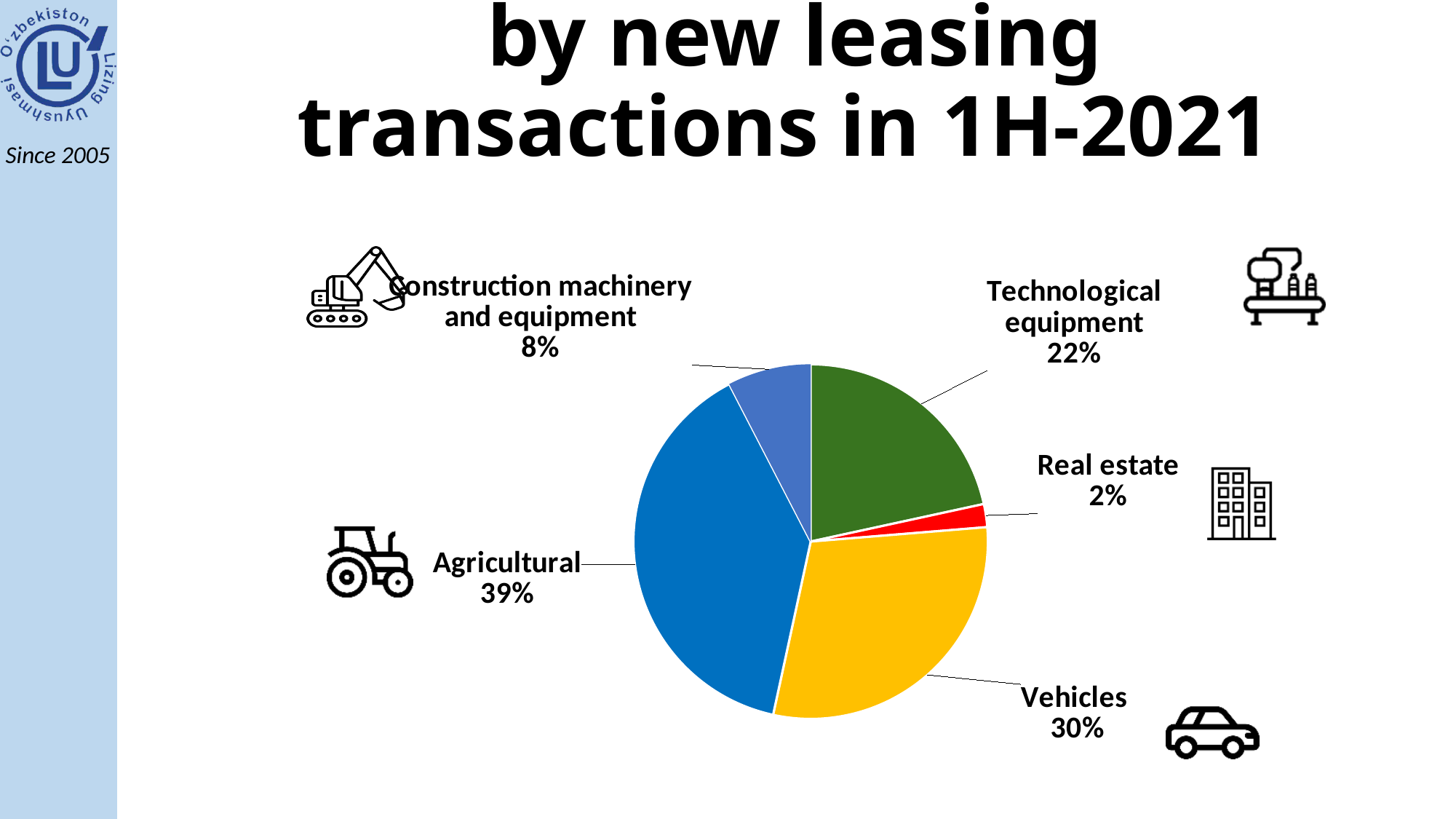
What share of new leasing transactions in 1H-2021 is Real estate? 2% What kind of chart is shown on the slide? Pie chart What share of new leasing transactions in 1H-2021 is Vehicles? 30% Which has a larger share, Technological equipment or Vehicles? Vehicles Which category has the largest share of new leasing transactions in 1H-2021? Agricultural How many categories are shown in the pie chart? 5 What share of new leasing transactions in 1H-2021 is Agricultural? 39% What colour is the Real estate slice in the pie chart? Red What share of new leasing transactions in 1H-2021 is Technological equipment? 22% What is the difference in percentage points between the Agricultural and Vehicles shares? 9 Which category has the smallest share of new leasing transactions in 1H-2021? Real estate What share of new leasing transactions in 1H-2021 is Construction machinery and equipment? 8%